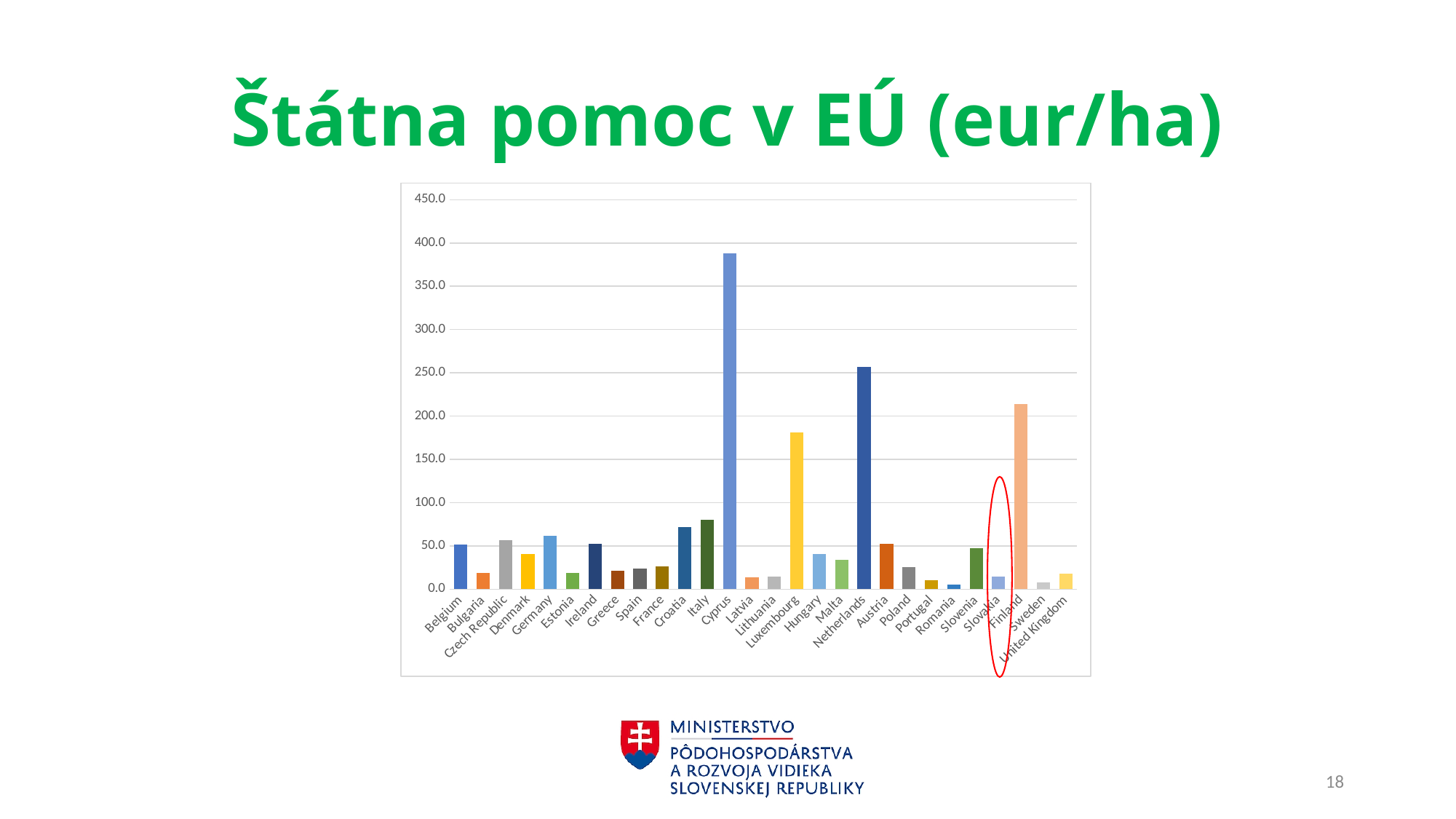
Which country has the highest value in the chart? Cyprus Is the value for Cyprus greater or less than 350? greater Which has the larger value, Finland or Luxembourg? Finland Is the value for Netherlands greater or less than 200? greater What kind of chart is shown on the slide? bar chart Which has the larger value, Cyprus or Netherlands? Cyprus Is the value for Luxembourg greater or less than 150? greater Which country's bar is circled in red on the chart? Slovakia Which has the larger value, Slovakia or Slovenia? Slovenia How many countries are shown on the x axis of the chart? 28